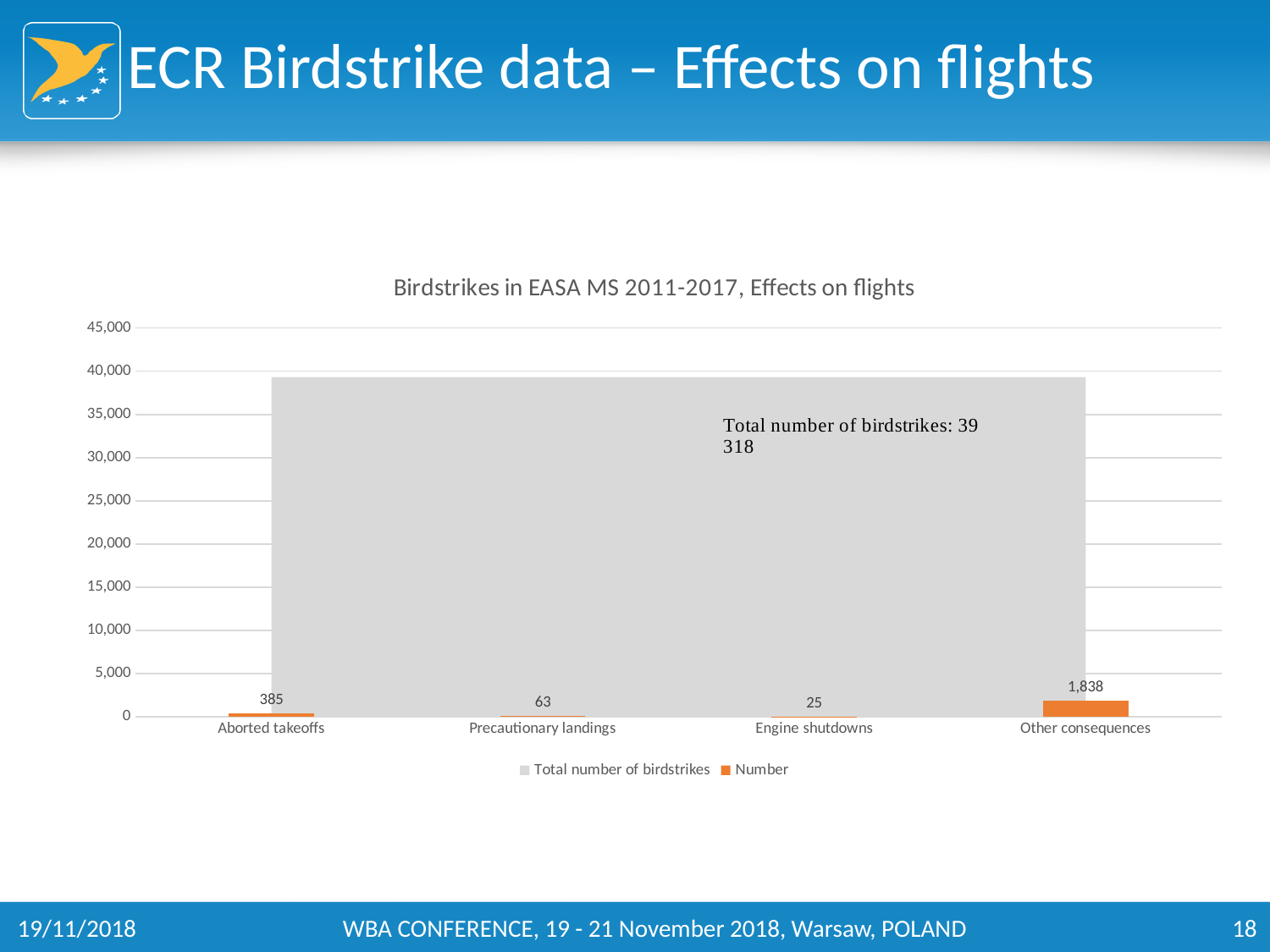
What kind of chart is shown on the slide? A combination chart: an area chart (gray total) with a bar chart (orange bars) Which category has the highest value in the Number series? Other consequences How many categories are shown on the x axis? 4 What is the value for Engine shutdowns in the Number series? 25 What is the difference between the Number values for Other consequences and Aborted takeoffs? 1,453 What is the value for Precautionary landings in the Number series? 63 What is the value for Aborted takeoffs in the Number series? 385 What is the value for Other consequences in the Number series? 1,838 Which is larger in the Number series: Aborted takeoffs or Precautionary landings? Aborted takeoffs How many series does the legend list? 2 Is the Number value for Other consequences greater or less than 5,000? less Which category has the lowest value in the Number series? Engine shutdowns